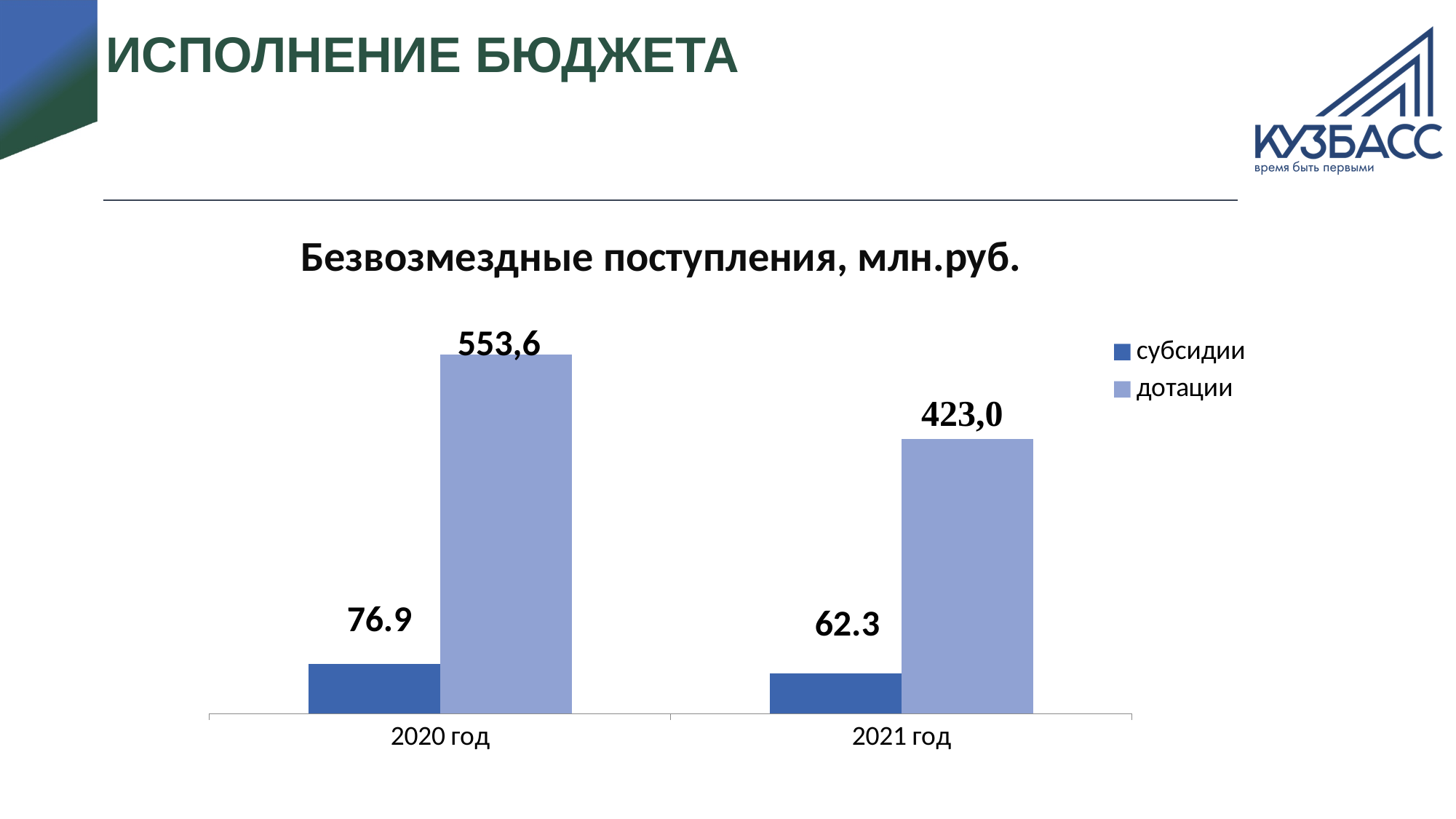
What is the value for дотации in 2021 год? 423,0 What is the value for дотации in 2020 год? 553,6 By how much did дотации decrease from 2020 год to 2021 год? 130,6 What is the difference between субсидии in 2020 год and 2021 год? 14.6 What is the value for субсидии in 2020 год? 76.9 What is the title of the chart? Безвозмездные поступления, млн.руб. What kind of chart is shown on the slide? bar chart Which year has the higher value for дотации? 2020 год Which year has the lower value for субсидии? 2021 год Which is larger in 2021 год: субсидии or дотации? дотации How many series does the legend list? 2 What is the value for субсидии in 2021 год? 62.3